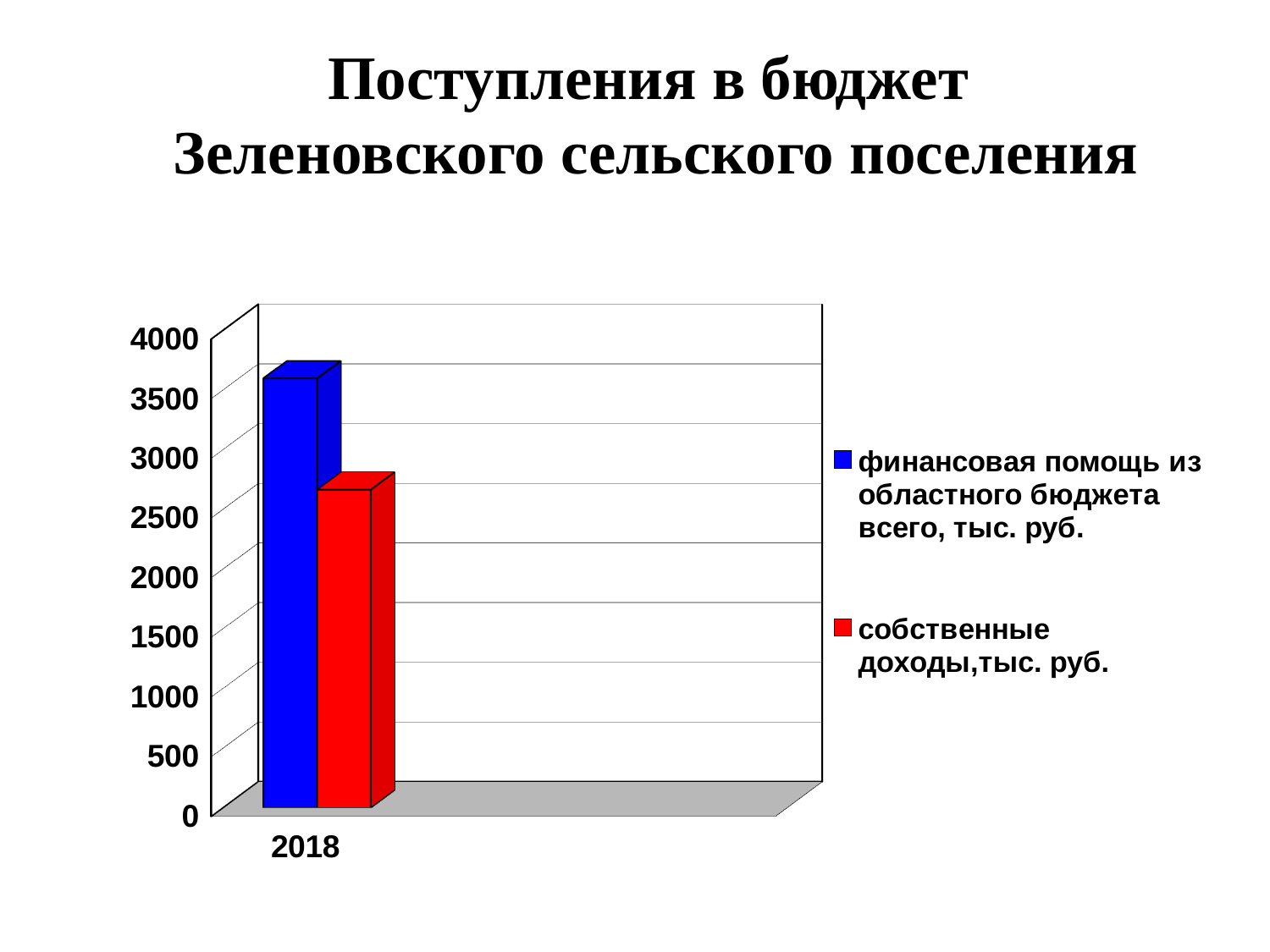
How many categories are shown on the x axis? 1 Which series has the lowest value in 2018? собственные доходы What kind of chart is shown on the slide? bar chart How many series does the legend list? 2 What is the highest value shown on the vertical axis? 4000 Is the value for финансовая помощь из областного бюджета in 2018 greater or less than 3000? greater Which year is shown on the x axis? 2018 Which series has the highest value in 2018? финансовая помощь из областного бюджета What colour represents собственные доходы in the legend? red Is the value for собственные доходы in 2018 greater or less than 2000? greater Which series has the higher value in 2018: финансовая помощь из областного бюджета or собственные доходы? финансовая помощь из областного бюджета Is the value for собственные доходы in 2018 greater or less than 3000? less